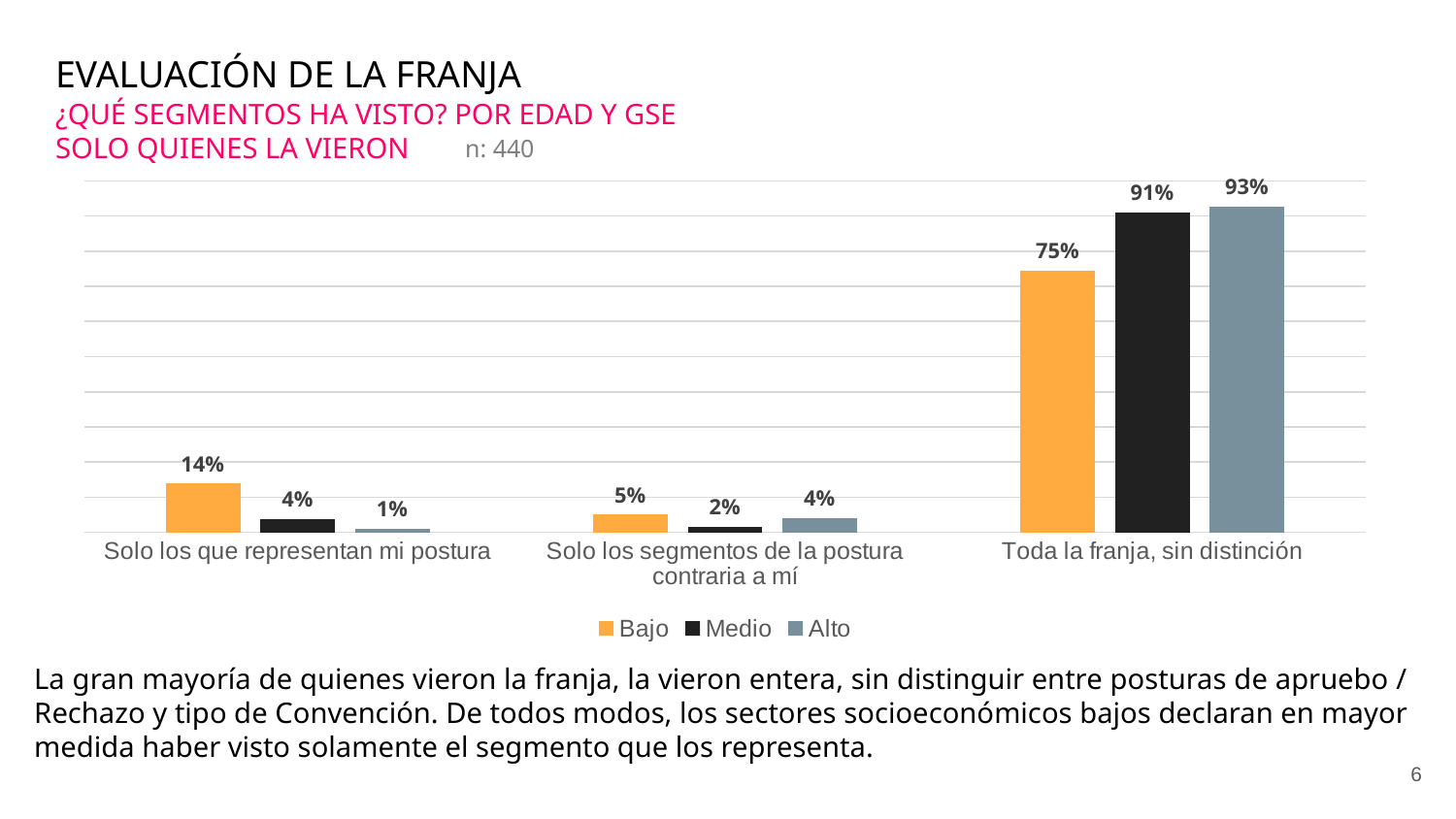
What is the value for Medio in the category "Solo los segmentos de la postura contraria a mí"? 2% Which is larger: the Bajo value for "Solo los que representan mi postura" or the Bajo value for "Solo los segmentos de la postura contraria a mí"? Solo los que representan mi postura What is the value for Bajo in the category "Solo los que representan mi postura"? 14% What kind of chart is shown on the slide? Bar chart How many categories are shown on the x axis? 3 Which colour represents the Bajo series in the legend? Orange Which series has the lowest value in the category "Solo los que representan mi postura"? Alto Which series has the highest value in the category "Toda la franja, sin distinción"? Alto How many series does the legend list? 3 What is the difference between the Medio and Bajo values in the category "Toda la franja, sin distinción"? 16% What is the sample size (n) shown on the slide? 440 What is the value for Alto in the category "Toda la franja, sin distinción"? 93%